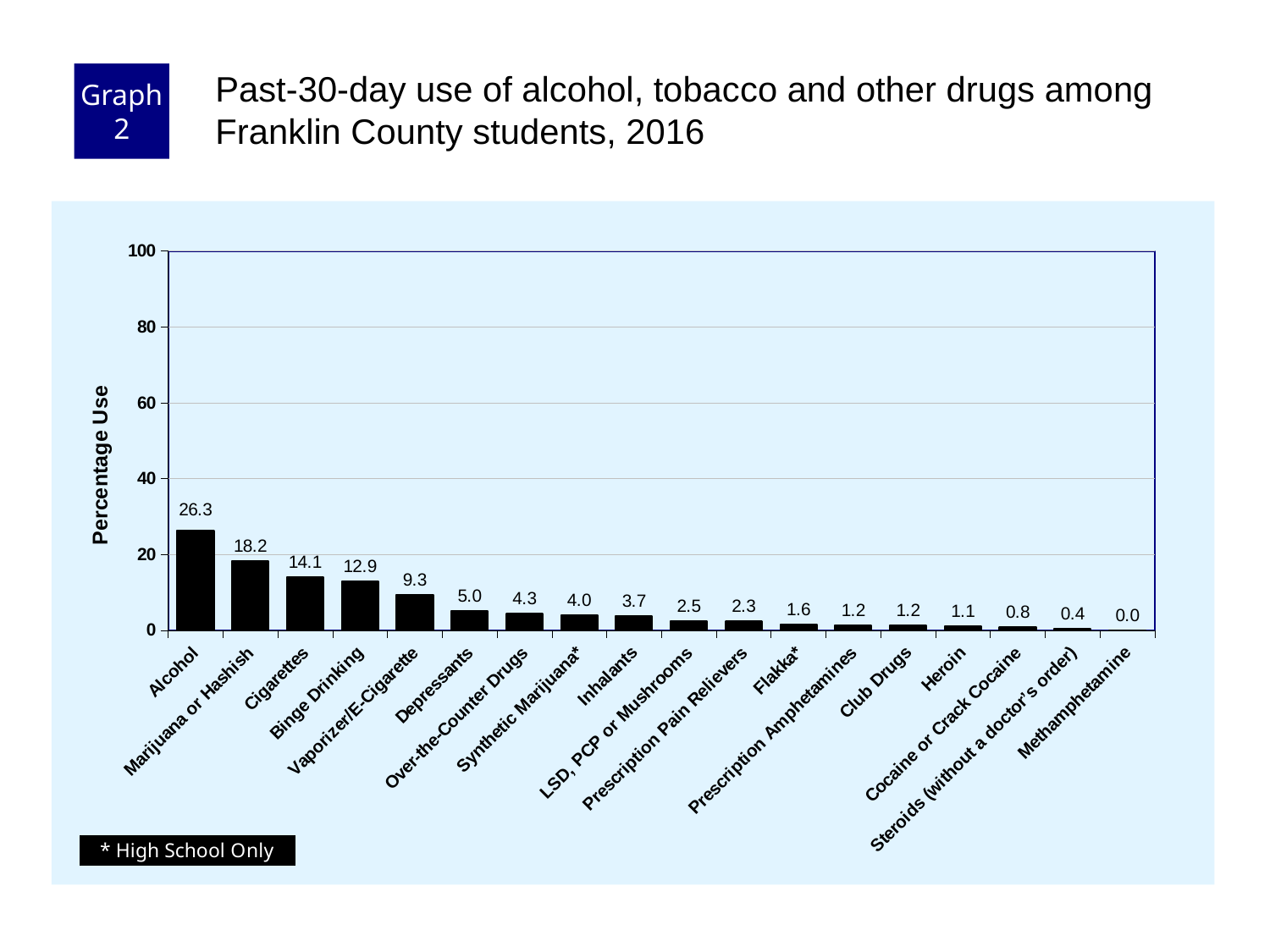
Which is larger, the value for Depressants or the value for Inhalants? Depressants Is the value for Alcohol greater or less than 20? greater What is the label on the y axis? Percentage Use What is the difference between the values for Alcohol and Marijuana or Hashish? 8.1 What is the difference between the values for Cigarettes and Binge Drinking? 1.2 What is the value shown for Vaporizer/E-Cigarette? 9.3 Which category has the highest percentage use? Alcohol What kind of chart is shown on the slide? Bar chart What is the past-30-day use percentage for Alcohol? 26.3 What is the value shown for Heroin? 1.1 Which category has the lowest percentage use? Methamphetamine How many categories are shown on the x axis? 18